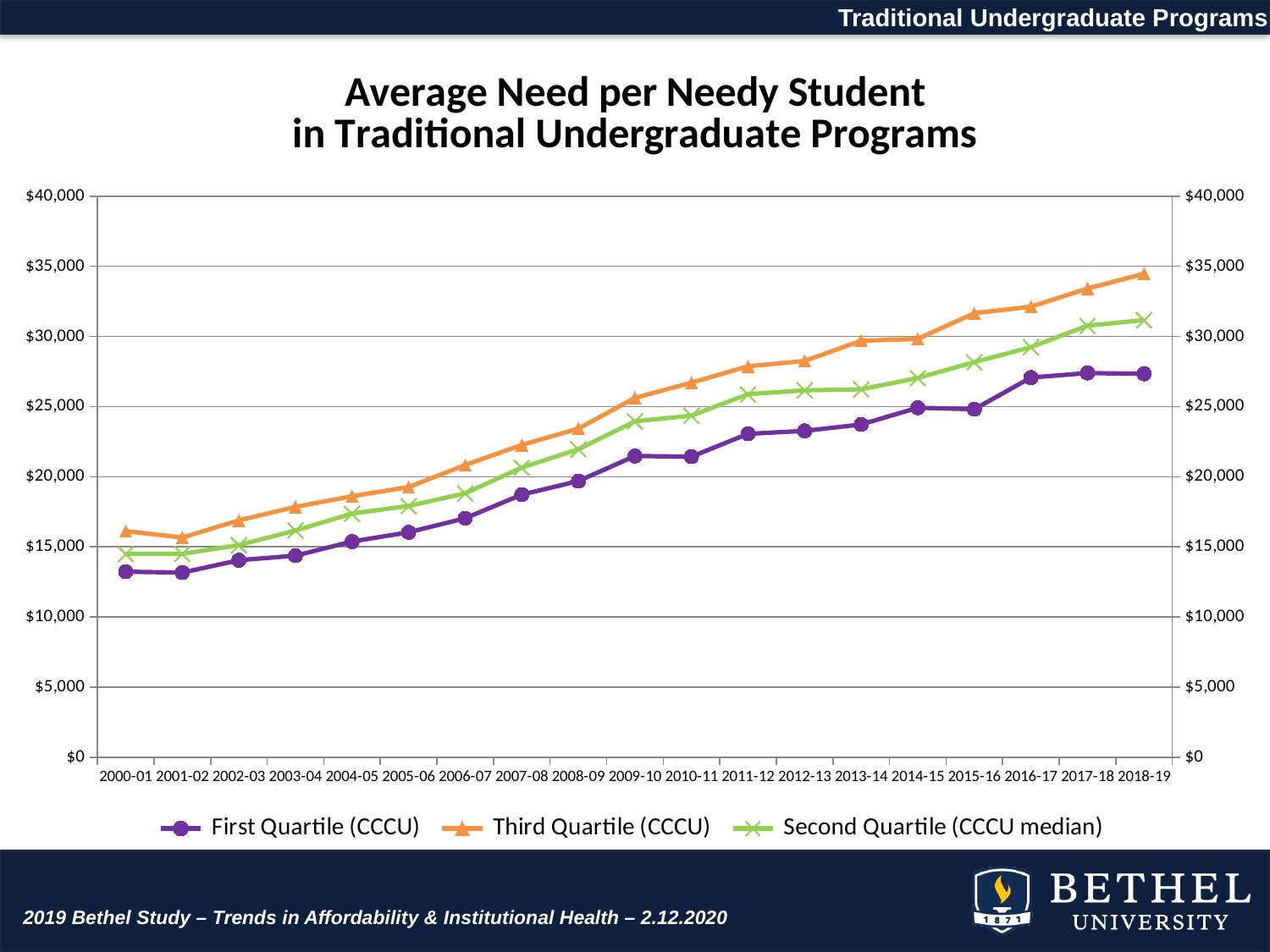
What kind of chart is shown on the slide? Line chart Which series has the lowest value in 2018-19? First Quartile (CCCU) In 2010-11, which is larger: the Third Quartile (CCCU) value or the First Quartile (CCCU) value? Third Quartile (CCCU) What is the title of the chart? Average Need per Needy Student in Traditional Undergraduate Programs Is the value for Second Quartile (CCCU median) in 2018-19 greater or less than $30,000? greater Is the value for First Quartile (CCCU) in 2018-19 greater or less than $25,000? greater Is the value for Third Quartile (CCCU) in 2018-19 greater or less than $30,000? greater How many series does the legend list? 3 Do the values for the Third Quartile (CCCU) series generally rise or fall from 2000-01 to 2018-19? Rise Which series has the highest value in 2018-19? Third Quartile (CCCU) How many academic years are plotted along the x axis? 19